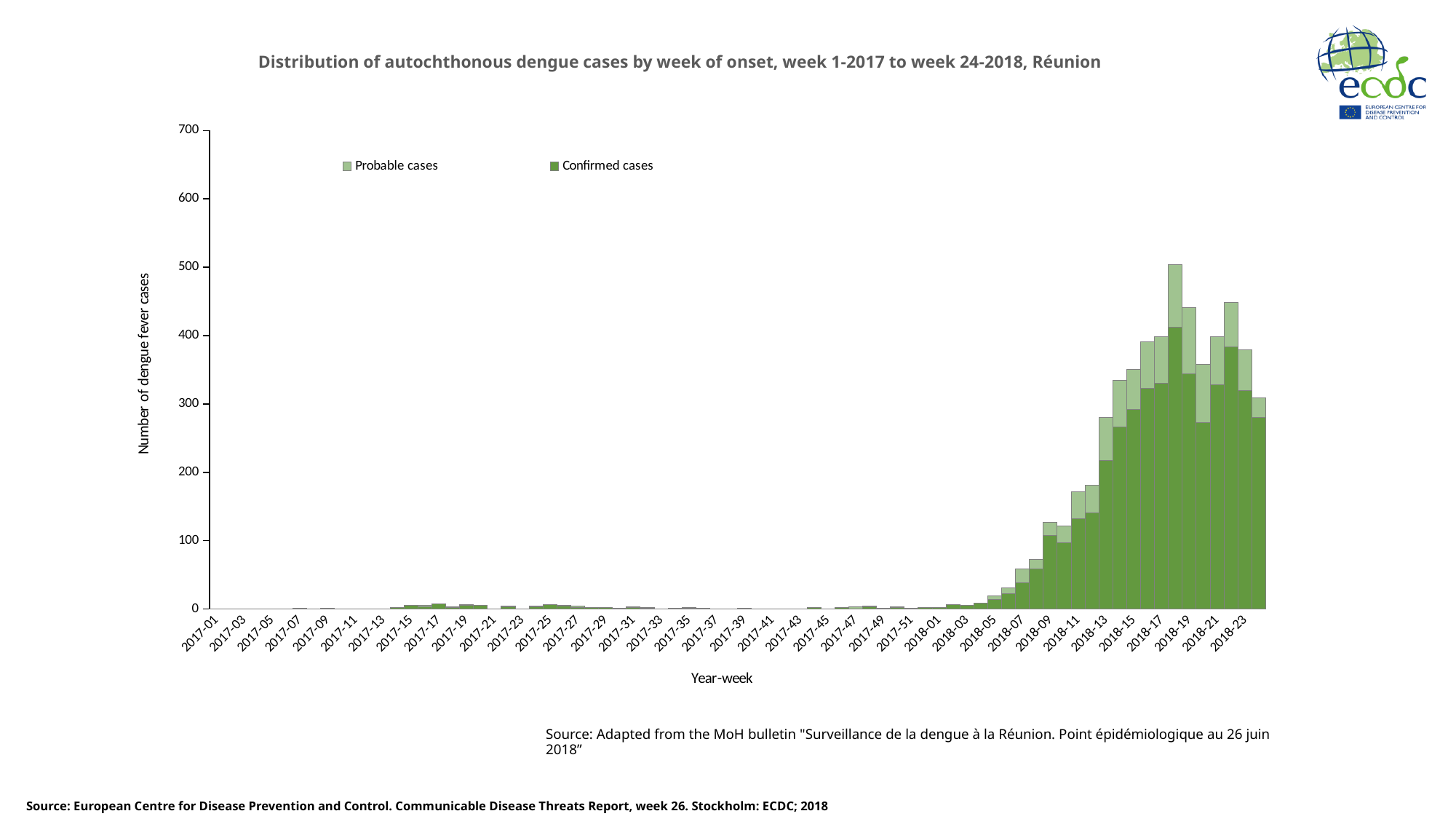
Is the total number of cases for 2018-07 greater or less than 100? less Which has more total cases, 2017-23 or 2018-23? 2018-23 Is the total number of cases for 2018-09 greater or less than 100? greater Which has more total cases, 2018-09 or 2018-17? 2018-17 Do the weekly case totals rise or fall from 2018-01 to 2018-17? rise What are the two series named in the legend? Probable cases and Confirmed cases Is the total number of cases for 2018-13 greater or less than 200? greater What kind of chart is shown on the slide? Stacked bar chart What is the label of the y axis? Number of dengue fever cases How many series does the legend list? 2